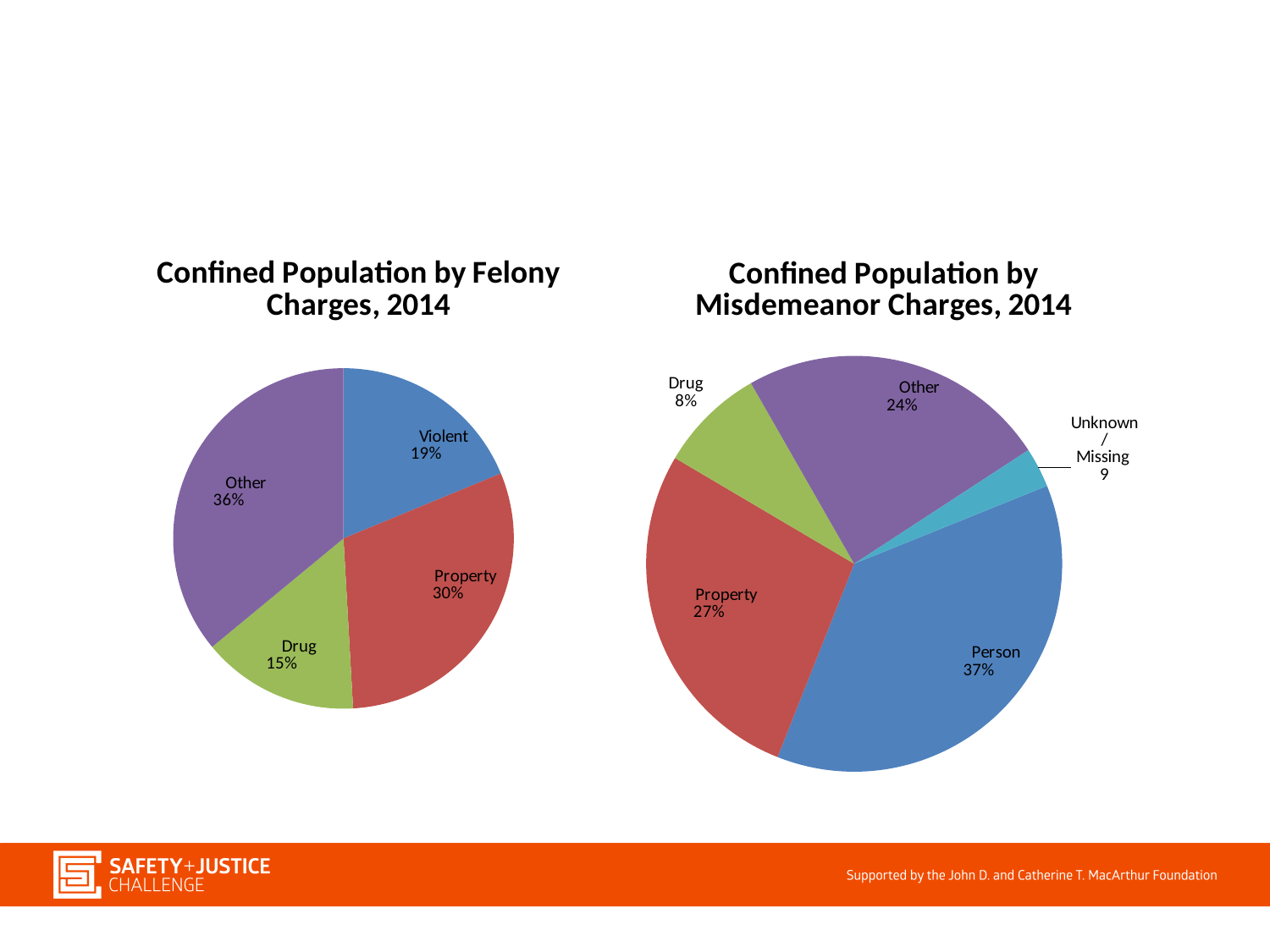
In the 'Confined Population by Misdemeanor Charges, 2014' chart, which category has the largest slice? Person In the 'Confined Population by Felony Charges, 2014' chart, what share of the pie is Violent? 19% In the 'Confined Population by Felony Charges, 2014' chart, how many slices does the pie have? 4 In the 'Confined Population by Felony Charges, 2014' chart, which category has the smallest slice? Drug In the 'Confined Population by Misdemeanor Charges, 2014' chart, which is larger, Property or Other? Property What type of chart is used on the right side of the slide? Pie chart In the 'Confined Population by Misdemeanor Charges, 2014' chart, what share of the pie is Drug? 8% In the 'Confined Population by Felony Charges, 2014' chart, what share of the pie is Property? 30% In the 'Confined Population by Misdemeanor Charges, 2014' chart, how many slices does the pie have? 5 In the 'Confined Population by Felony Charges, 2014' chart, what is the difference in percentage points between Other and Drug? 21 In the 'Confined Population by Felony Charges, 2014' chart, which category has the largest slice? Other